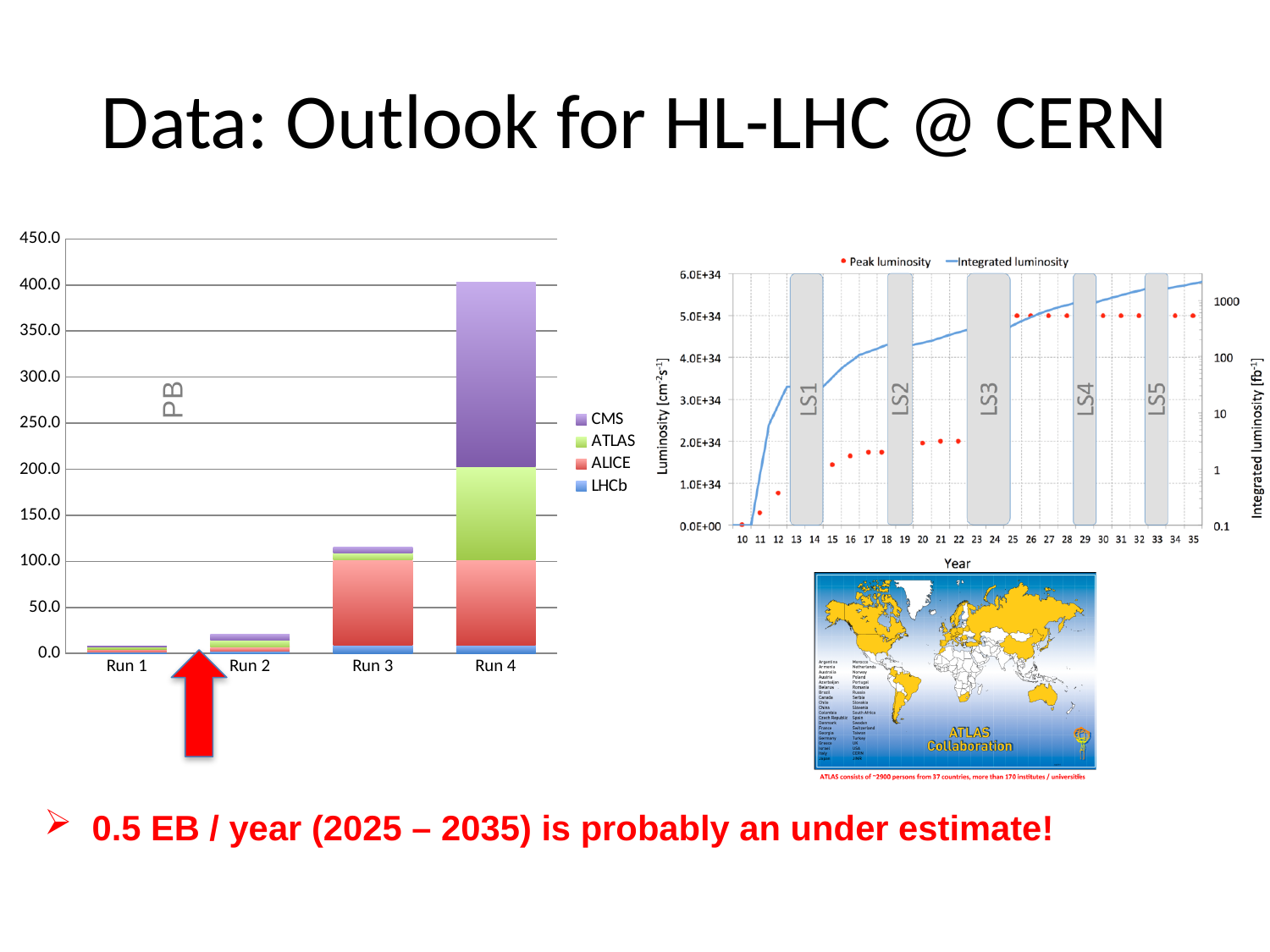
In the left bar chart, which run has the tallest stacked bar? Run 4 In the left bar chart, how many series does the legend list? 4 What kind of chart is the chart on the left of the slide? stacked bar chart In the luminosity chart on the right, how many series does the legend list? 2 In the left bar chart, is the total for Run 4 greater or less than 350? greater In the left bar chart, is the total for Run 2 greater or less than 50? less In the left bar chart, which series is shown in purple? CMS In the left bar chart, is the total for Run 3 greater or less than 100? greater In the left bar chart, do the stacked bar totals rise or fall from Run 1 to Run 4? rise In the left bar chart, what unit label is written on the plot area? PB In the left bar chart, which run has the shortest stacked bar? Run 1 In the left bar chart, how many run categories are shown on the x axis? 4